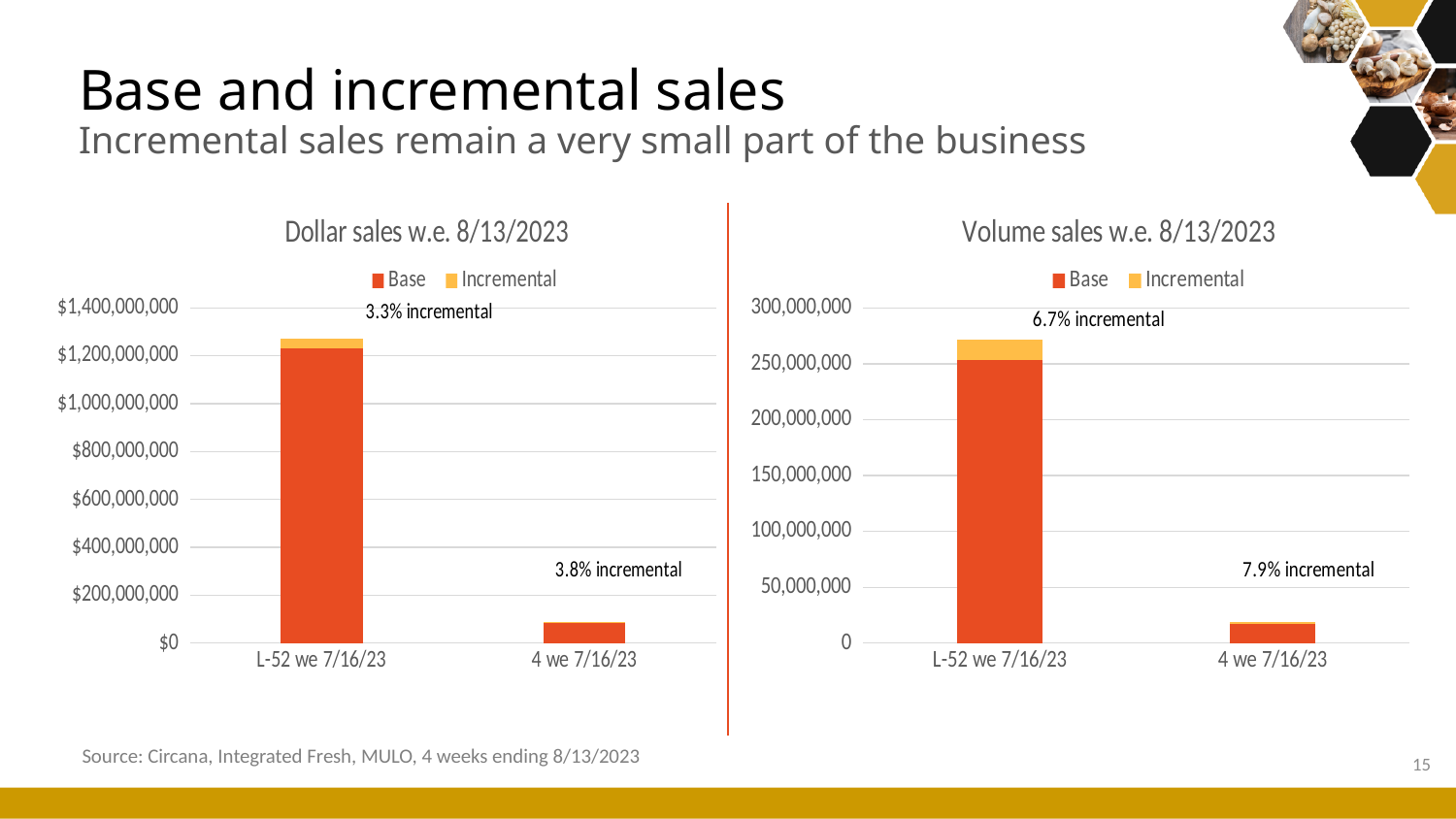
How many categories are shown on the x axis of the Volume sales w.e. 8/13/2023 chart? 2 In the Volume sales w.e. 8/13/2023 chart, what percentage of sales is labelled as incremental for L-52 we 7/16/23? 6.7% incremental In the Dollar sales w.e. 8/13/2023 chart, is the total bar for L-52 we 7/16/23 greater or less than $1,000,000,000? greater In the Dollar sales w.e. 8/13/2023 chart, is the total bar for 4 we 7/16/23 greater or less than $200,000,000? less How many series does the legend of the Dollar sales w.e. 8/13/2023 chart list? 2 In the Volume sales w.e. 8/13/2023 chart, is the total bar for L-52 we 7/16/23 greater or less than 200,000,000? greater In the Dollar sales w.e. 8/13/2023 chart, what percentage of sales is labelled as incremental for L-52 we 7/16/23? 3.3% incremental In the Volume sales w.e. 8/13/2023 chart, what percentage of sales is labelled as incremental for 4 we 7/16/23? 7.9% incremental What kind of chart is the Dollar sales w.e. 8/13/2023 chart? Stacked bar chart In the Dollar sales w.e. 8/13/2023 chart, what percentage of sales is labelled as incremental for 4 we 7/16/23? 3.8% incremental In the Volume sales w.e. 8/13/2023 chart, which category has the taller bar, L-52 we 7/16/23 or 4 we 7/16/23? L-52 we 7/16/23